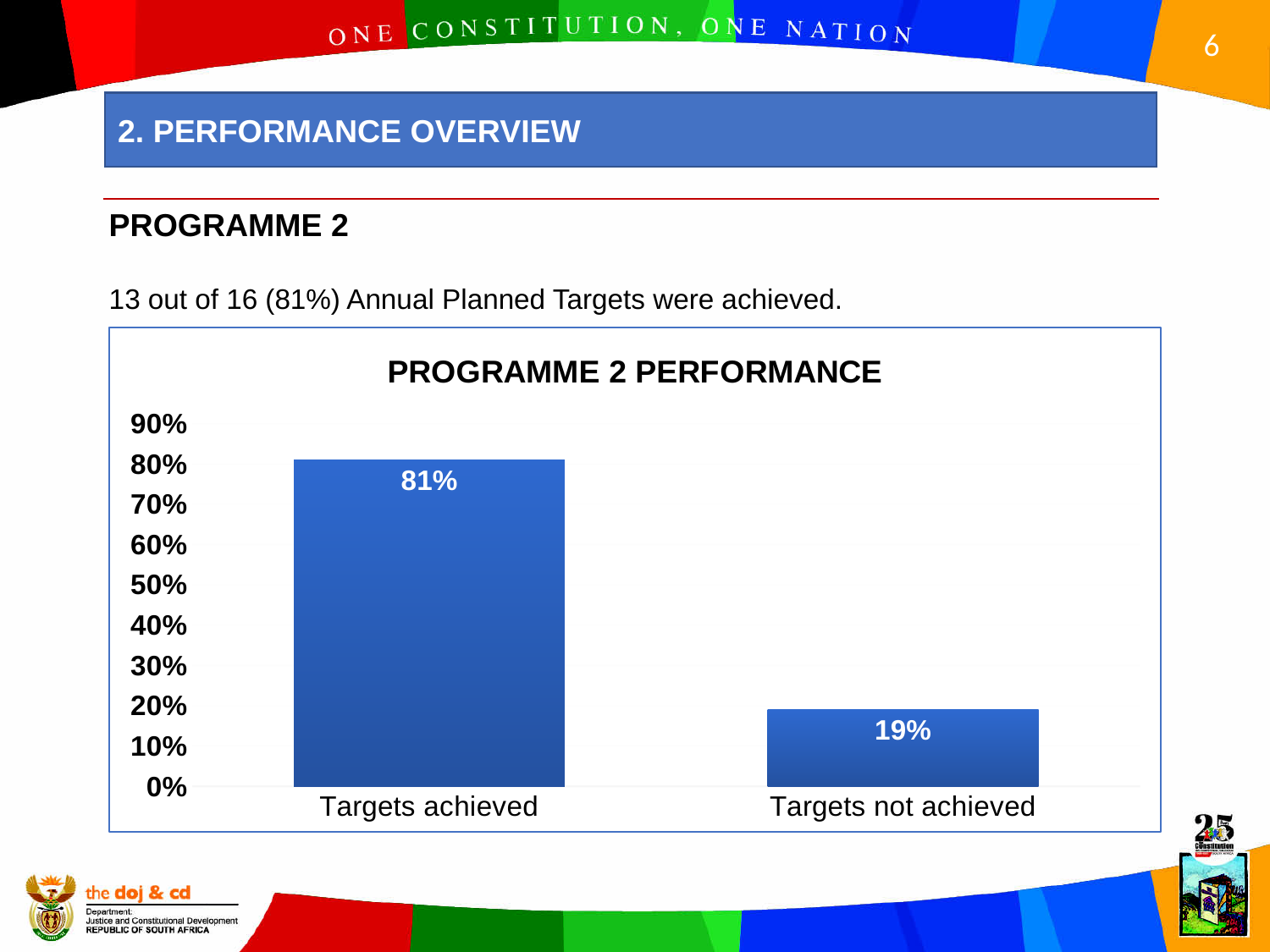
What is the title of the chart? PROGRAMME 2 PERFORMANCE What is the highest value shown on the vertical axis? 90% What is the value for Targets achieved? 81% Which category has the lowest value? Targets not achieved What is the value for Targets not achieved? 19% What kind of chart is shown? bar chart What is the difference between the values for Targets achieved and Targets not achieved? 62% Which category has the highest value? Targets achieved Is the value for Targets achieved greater or less than 80%? greater Is the value for Targets not achieved greater or less than 20%? less Which is larger, the value for Targets achieved or Targets not achieved? Targets achieved How many categories are shown on the chart? 2